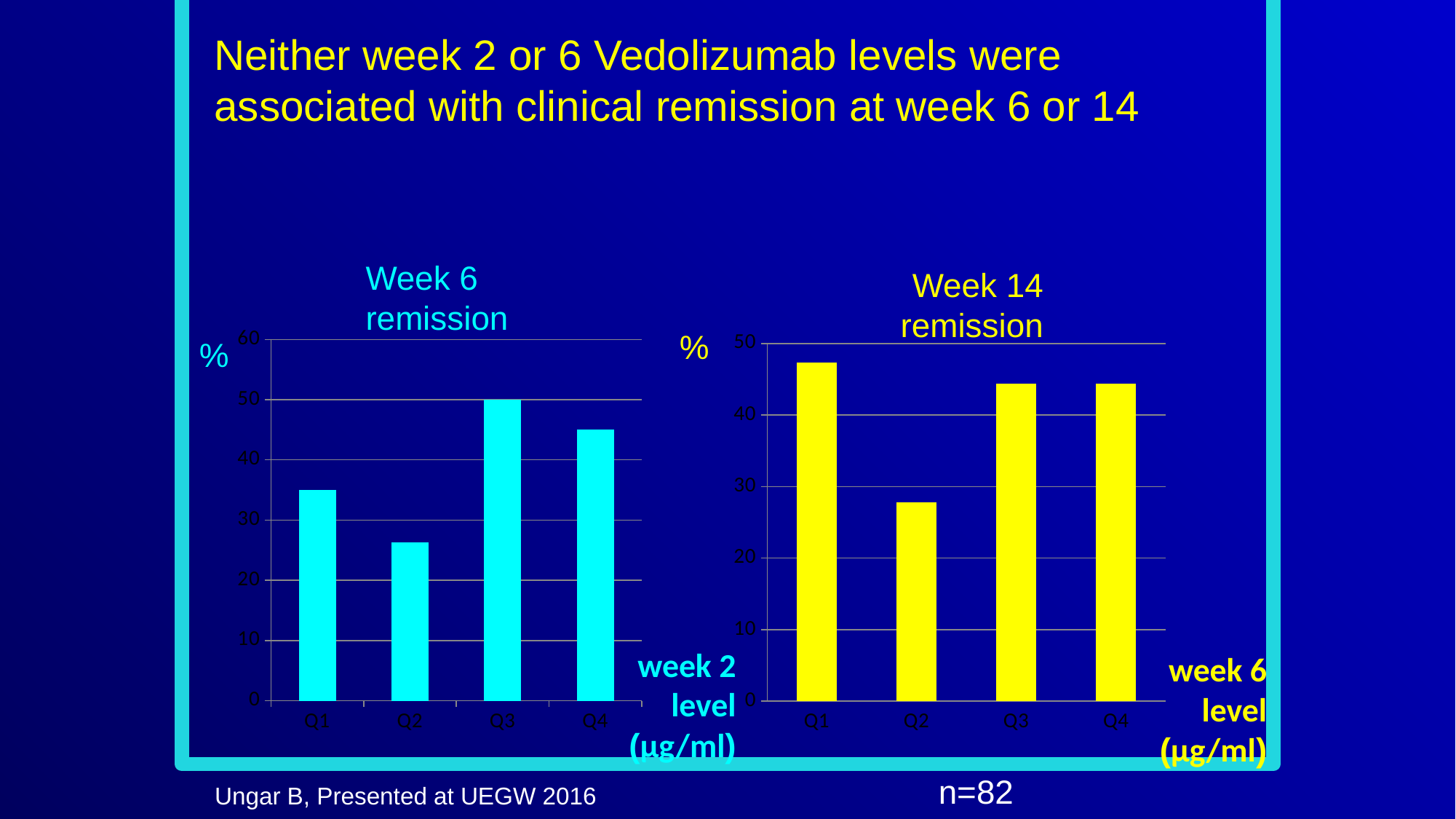
In the Week 14 remission chart, which is larger, the value for Q2 or the value for Q4? Q4 In the Week 6 remission chart, which is larger, the value for Q1 or the value for Q3? Q3 In the Week 14 remission chart, is the value for Q1 greater or less than 40? greater In the Week 6 remission chart, which quartile has the lowest remission rate? Q2 In the Week 6 remission chart, which quartile has the highest remission rate? Q3 In the Week 6 remission chart, is the value for Q2 greater or less than 30? less In the Week 6 remission chart, is the value for Q1 greater or less than 30? greater In the Week 14 remission chart, which quartile has the lowest remission rate? Q2 How many quartile categories are shown in the Week 14 remission chart? 4 What is the x-axis label of the Week 14 remission chart? week 6 level (µg/ml) What type of chart is the Week 6 remission chart? Bar chart